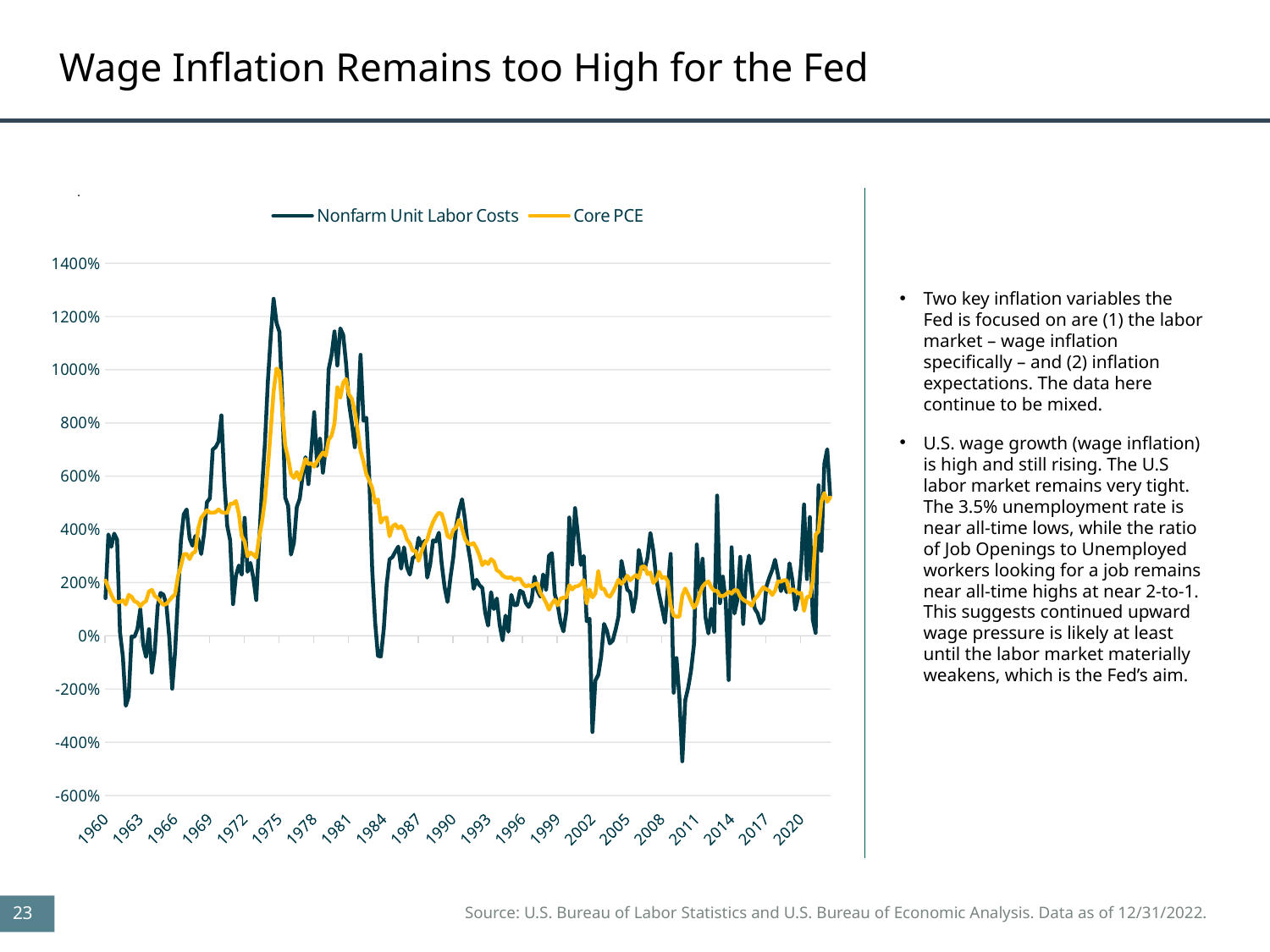
Does the Core PCE series ever fall below 0%? No What is the highest value labeled on the vertical axis? 1400% Around which labeled year does the Nonfarm Unit Labor Costs series reach its highest value? 1975 What are the two series named in the chart legend? Nonfarm Unit Labor Costs and Core PCE At the peak around 1975, which series is higher, Nonfarm Unit Labor Costs or Core PCE? Nonfarm Unit Labor Costs Is the peak value of the Nonfarm Unit Labor Costs series greater or less than 1200%? greater How many series does the chart legend list? 2 Which series is drawn in yellow/gold? Core PCE Does the Nonfarm Unit Labor Costs series ever fall below -400%? Yes Around 2002, which series is higher, Nonfarm Unit Labor Costs or Core PCE? Core PCE What kind of chart is shown on the slide? Line chart